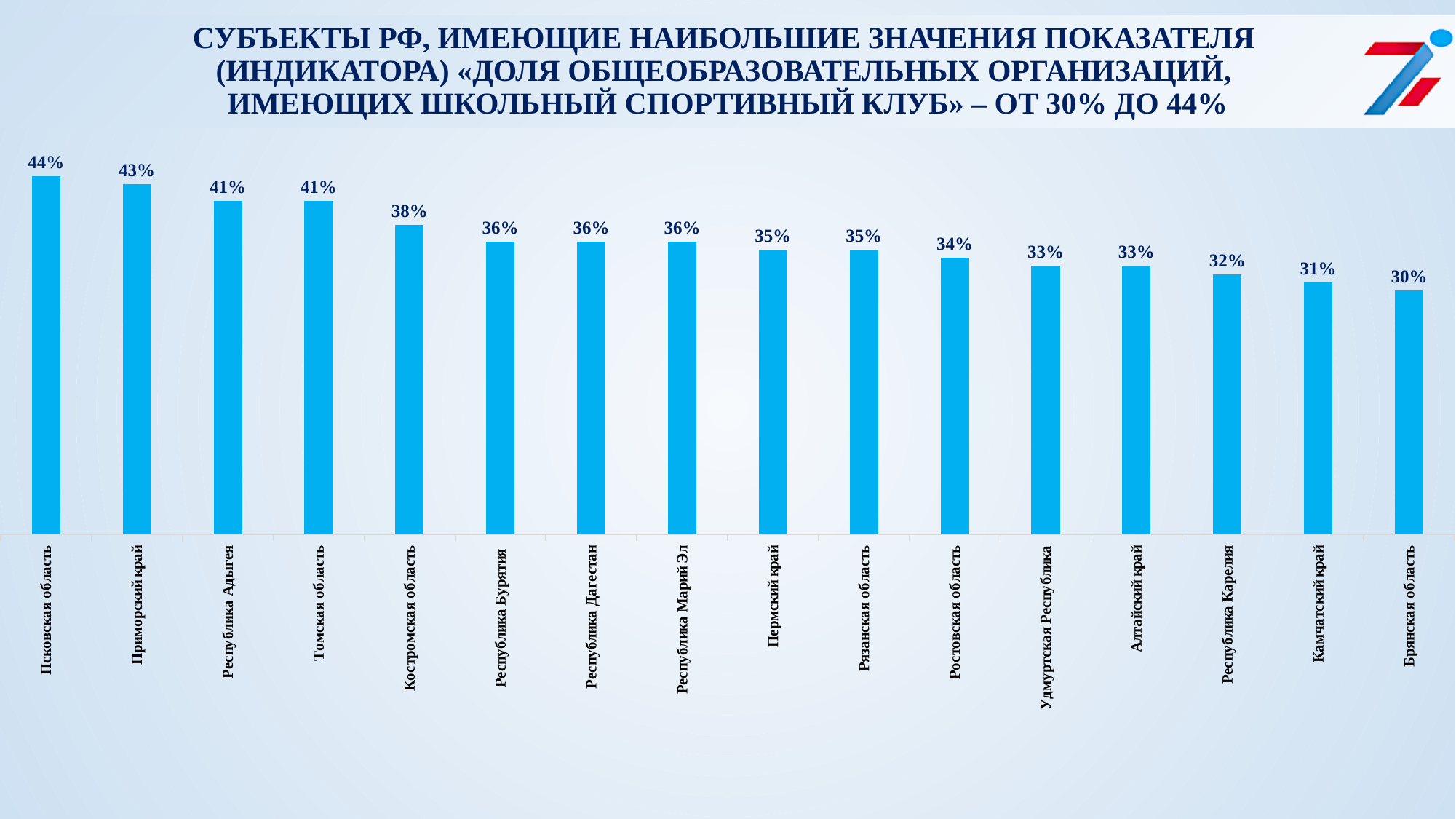
What is the difference between the values for Приморский край and Камчатский край? 12% How many regions are shown on the chart? 16 Which region has the highest value on the chart? Псковская область What is the difference between the values for Псковская область and Брянская область? 14% What is the value for Псковская область? 44% What is the value for Ростовская область? 34% Which is larger, the value for Республика Адыгея or the value for Пермский край? Республика Адыгея What is the value for Костромская область? 38% Do the values rise or fall from left to right along the x axis? Fall What is the value for Республика Карелия? 32% Which region has the lowest value on the chart? Брянская область What kind of chart is shown on the slide? Bar chart